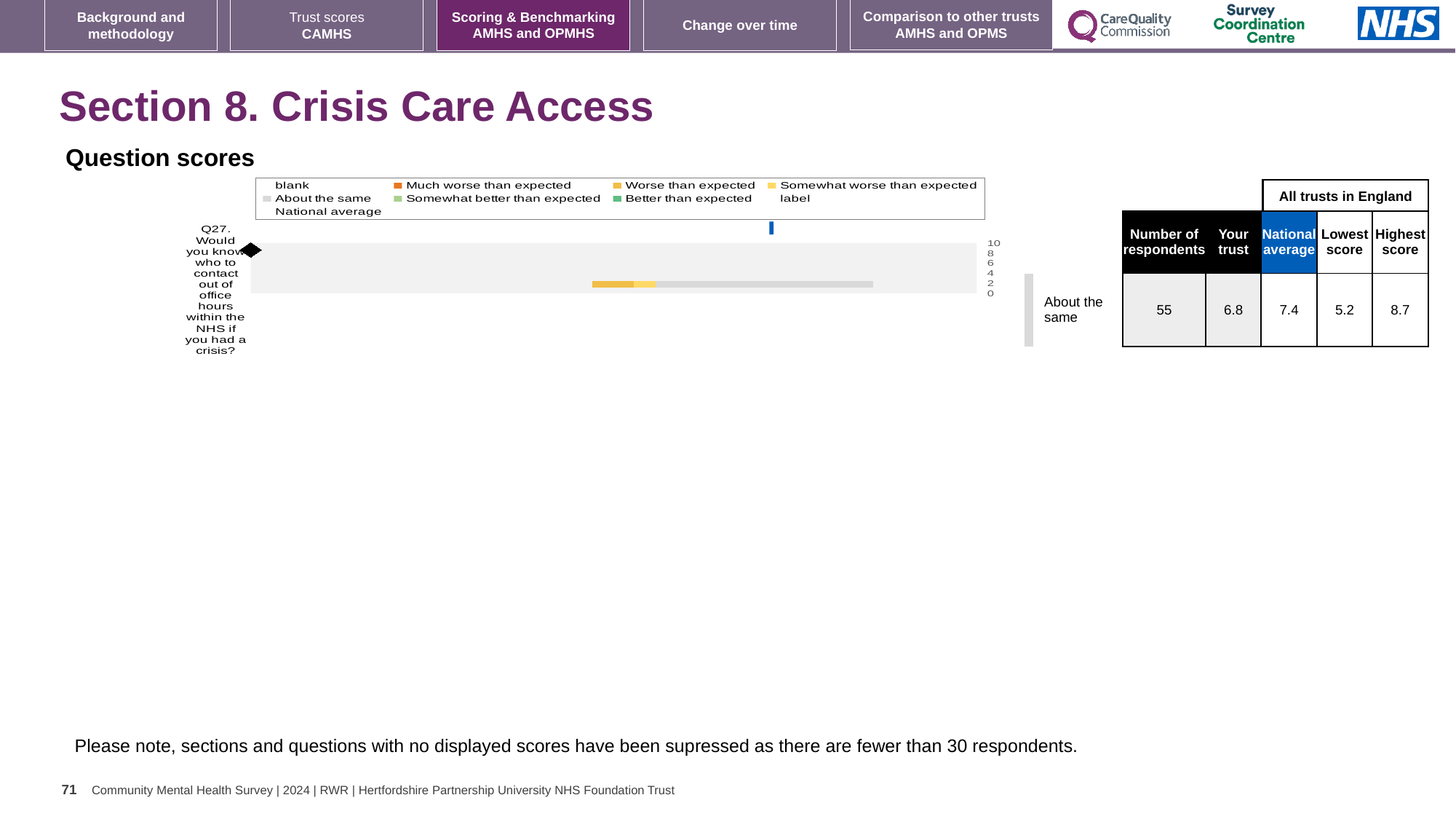
In the table beside the chart, what is the number of respondents for Q27? 55 In the table beside the chart, what is the 'Your trust' score for Q27? 6.8 For Q27, which is larger: the 'Your trust' score or the national average? National average In the table beside the chart, what is the lowest score among all trusts in England for Q27? 5.2 For Q27, what is the difference between the national average and the 'Your trust' score? 0.6 In the table beside the chart, what is the national average score for Q27? 7.4 In the table beside the chart, what is the highest score among all trusts in England for Q27? 8.7 What benchmark category is shown beside the bar for Q27? About the same Which question is plotted in the Question scores chart? Q27. Would you know who to contact out of office hours within the NHS if you had a crisis? How many questions (categories) are plotted in the Question scores chart? 1 How many entries does the legend of the Question scores chart list? 9 What kind of chart is shown under 'Question scores'? bar chart